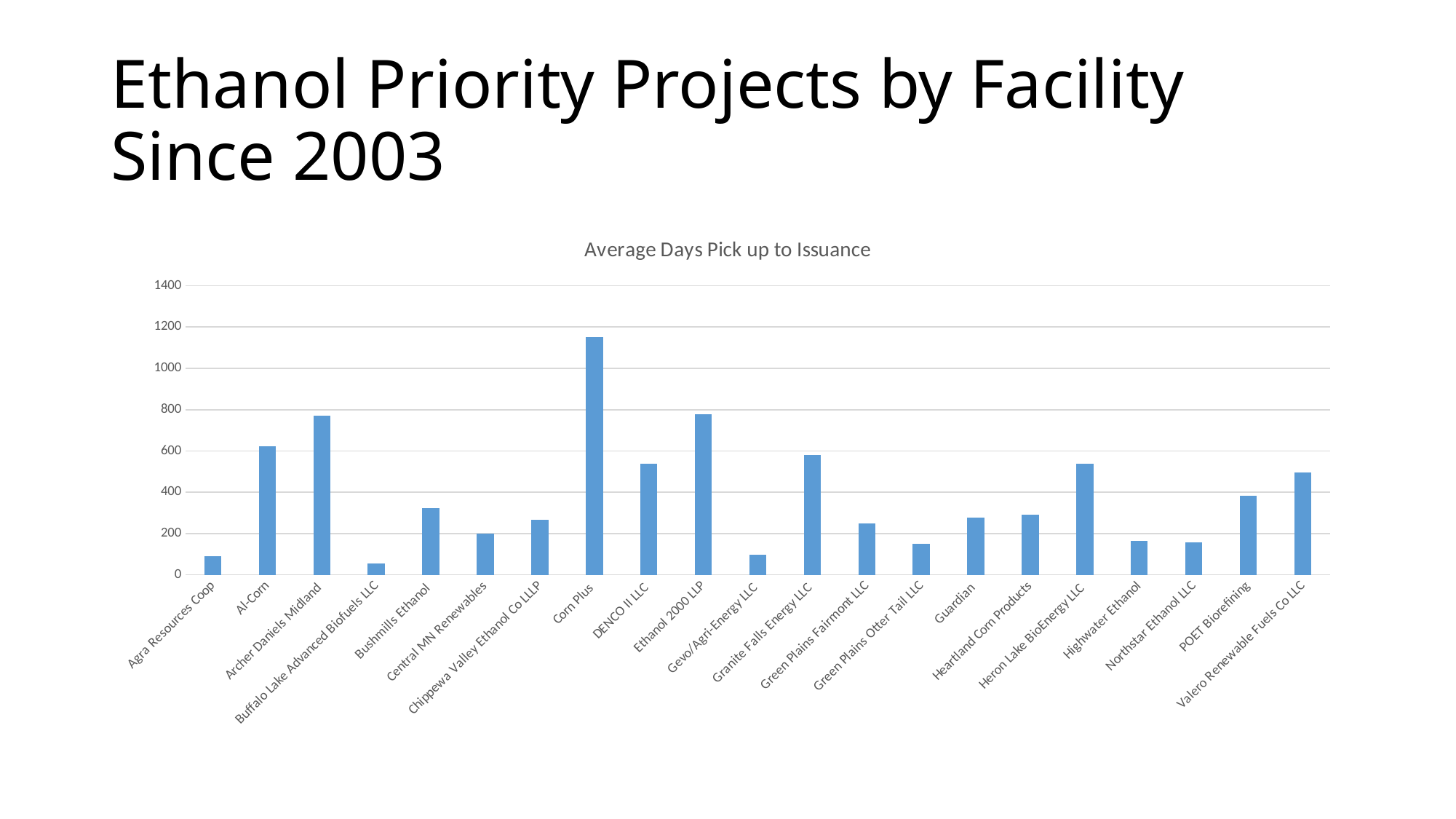
How many facilities are shown on the x axis of the chart? 21 Which has a larger value, Corn Plus or Ethanol 2000 LLP? Corn Plus Is the value for Heron Lake BioEnergy LLC greater or less than 400? greater What kind of chart is shown on the slide? bar chart Which has a larger value, Al-Corn or DENCO II LLC? Al-Corn Is the value for Bushmills Ethanol greater or less than 200? greater Which facility has the highest average days from pick up to issuance? Corn Plus What is the title of the chart? Average Days Pick up to Issuance Which facility has the lowest average days from pick up to issuance? Buffalo Lake Advanced Biofuels LLC Is the value for Corn Plus greater or less than 1000? greater